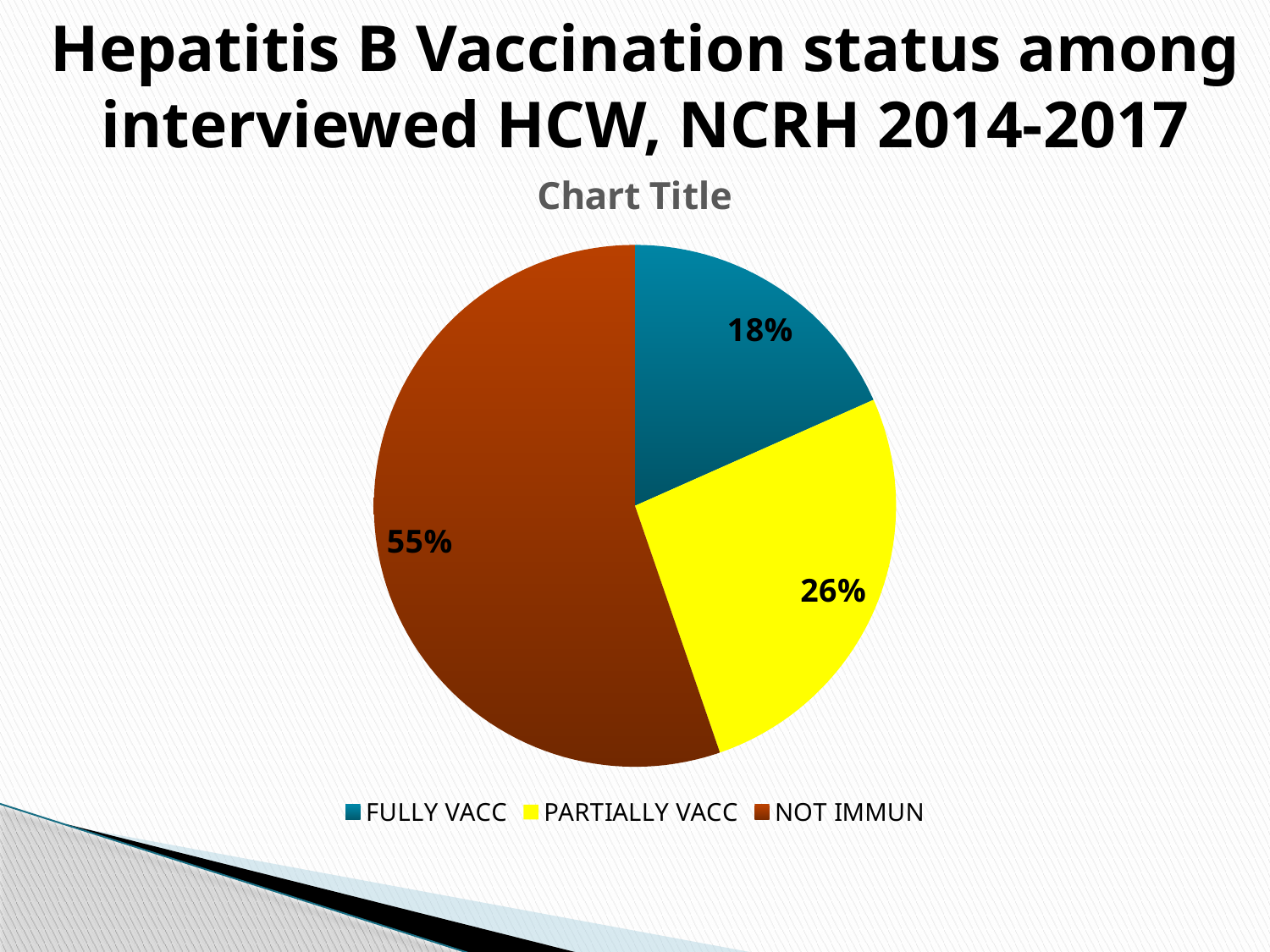
What is the difference in percentage points between PARTIALLY VACC and FULLY VACC? 8 How many categories does the pie chart show? 3 What percentage of interviewed HCW were partially vaccinated? 26% What percentage of interviewed HCW were not immune? 55% What kind of chart is shown on the slide? Pie chart Which category has the smallest share of the pie? FULLY VACC Which category has the largest share of the pie? NOT IMMUN What colour is the NOT IMMUN slice? Brown What is the title printed directly above the pie chart? Chart Title Which is larger, the share for PARTIALLY VACC or the share for FULLY VACC? PARTIALLY VACC What percentage of interviewed HCW were fully vaccinated? 18% What is the difference in percentage points between NOT IMMUN and FULLY VACC? 37